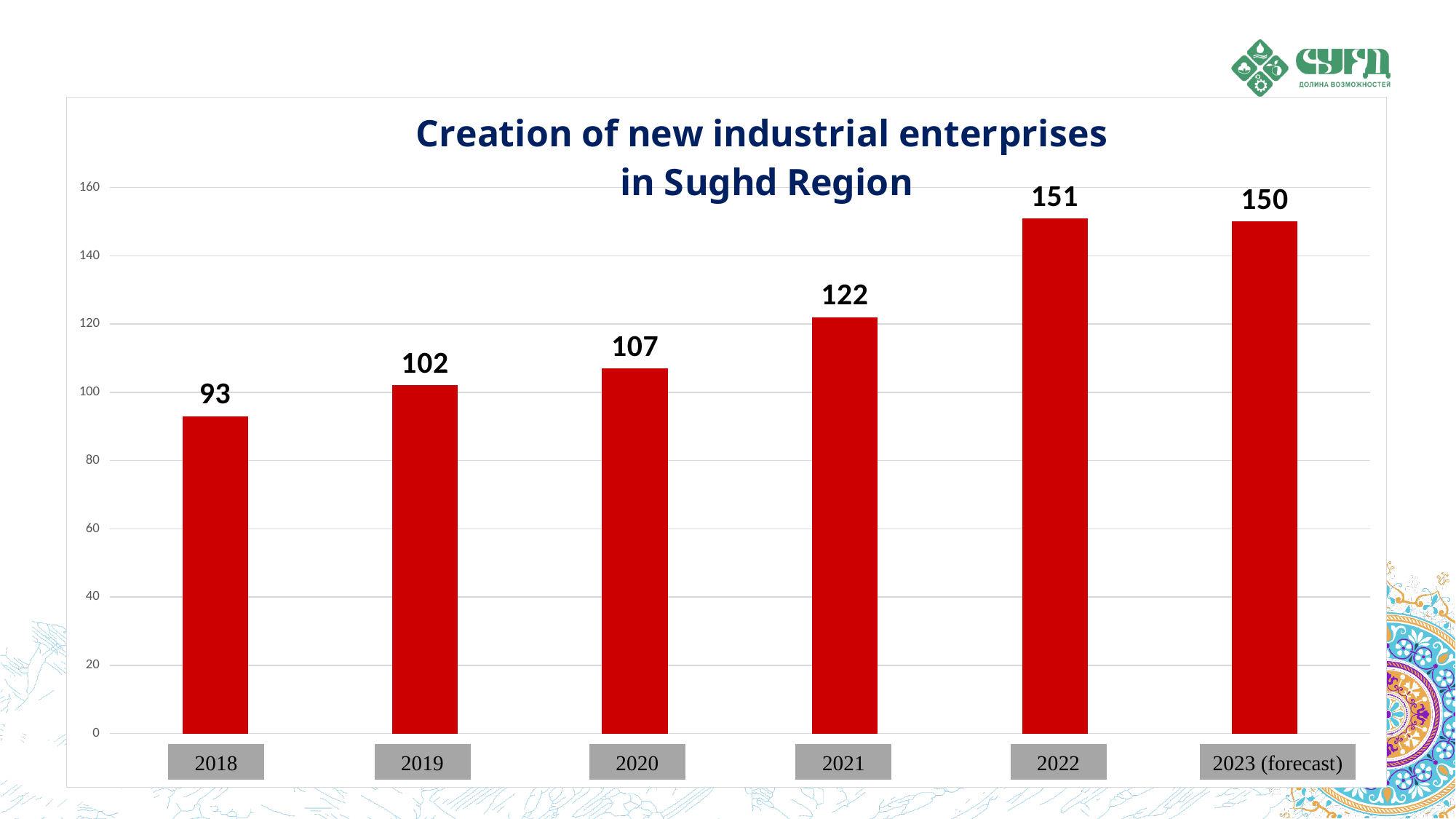
Which year has the highest value? 2022 Which is larger, the value for 2019 or the value for 2020? 2020 What is the value for 2023 (forecast)? 150 Which year has the lowest value? 2018 How many years are shown on the x axis? 6 What is the title of the chart? Creation of new industrial enterprises in Sughd Region What is the difference between the values for 2021 and 2020? 15 Is the value for 2021 greater or less than 120? greater What is the difference between the values for 2022 and 2018? 58 What kind of chart is shown on the slide? bar chart What is the value for 2021? 122 What is the value for 2018? 93